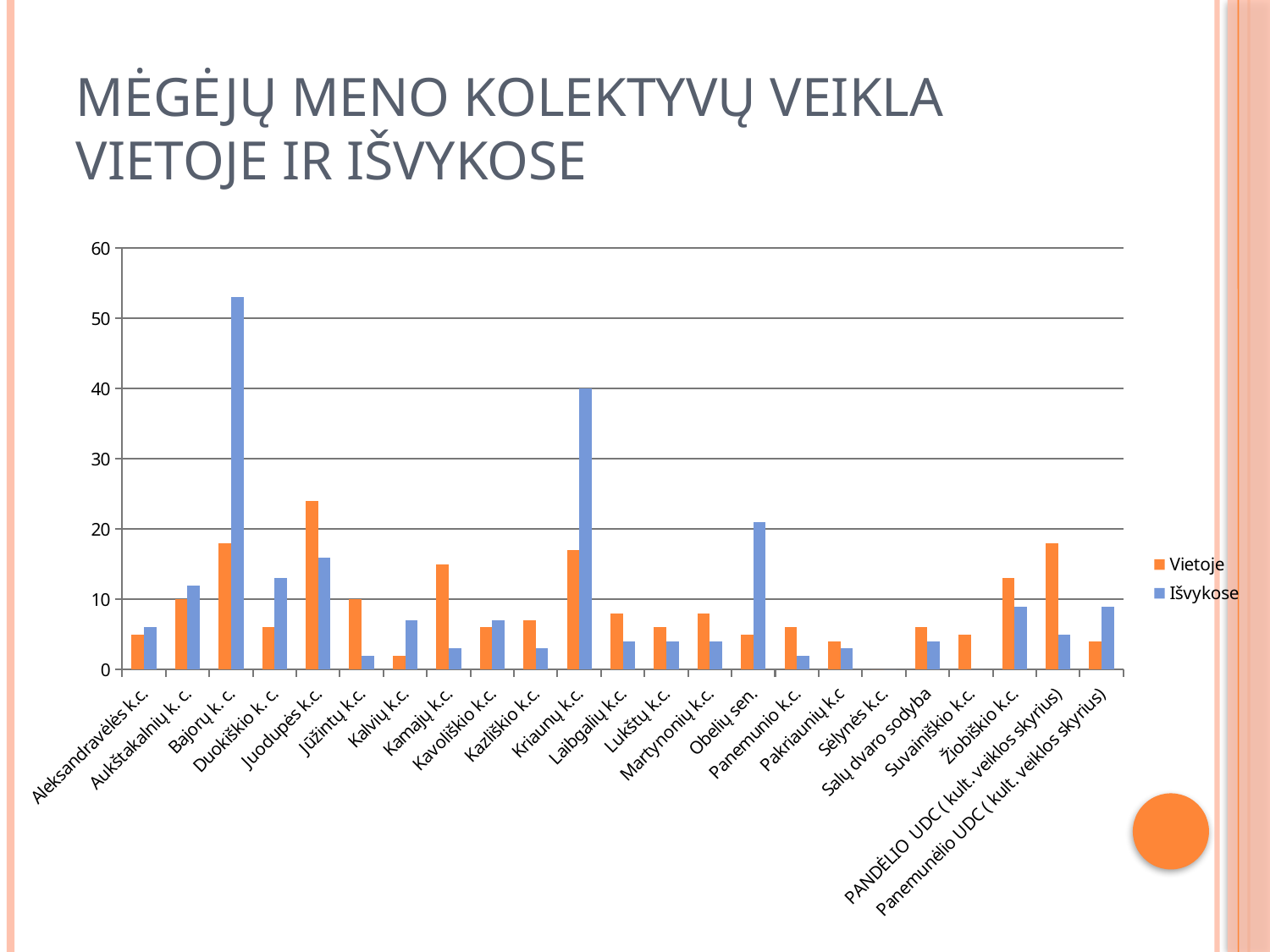
What is the Išvykose value for Kriaunų k.c.? 40 What type of chart is shown on the slide? bar chart For Kamajų k.c., which is larger: the Vietoje value or the Išvykose value? Vietoje What are the two series named in the legend? Vietoje and Išvykose How many series does the legend list? 2 Which category has the highest Išvykose value? Bajorų k. c. Is the Vietoje value for Kalvių k.c. greater or less than 10? less For Obelių sen., which is larger: the Vietoje value or the Išvykose value? Išvykose How many categories are shown on the x axis? 23 Is the Išvykose value for Bajorų k. c. greater or less than 50? greater Which category has the highest Vietoje value? Juodupės k.c.